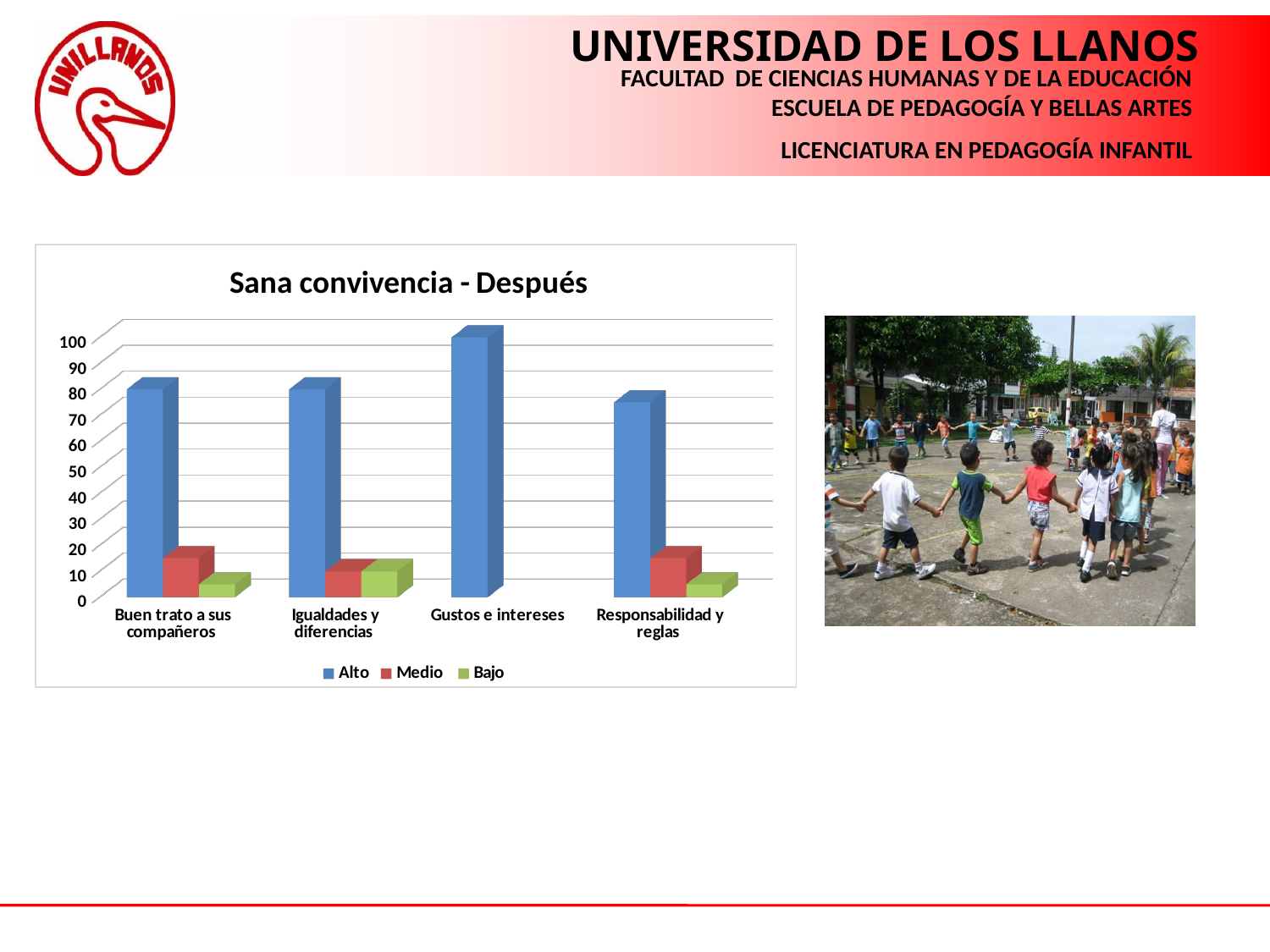
How many series does the chart's legend list? 3 What kind of chart is shown on the slide? bar chart How many categories are shown on the x axis of the chart? 4 What is the title of the chart? Sana convivencia - Después Which category has the highest value for the Alto series? Gustos e intereses For Buen trato a sus compañeros, which series has the larger value, Medio or Bajo? Medio Is the Alto value for Gustos e intereses greater or less than 90? greater For Responsabilidad y reglas, which series has the larger value, Alto or Medio? Alto Is the Medio value for Buen trato a sus compañeros greater or less than 30? less What are the series names listed in the legend? Alto, Medio, Bajo Which category has the lowest value for the Alto series? Responsabilidad y reglas Is the Alto value for Buen trato a sus compañeros greater or less than 50? greater